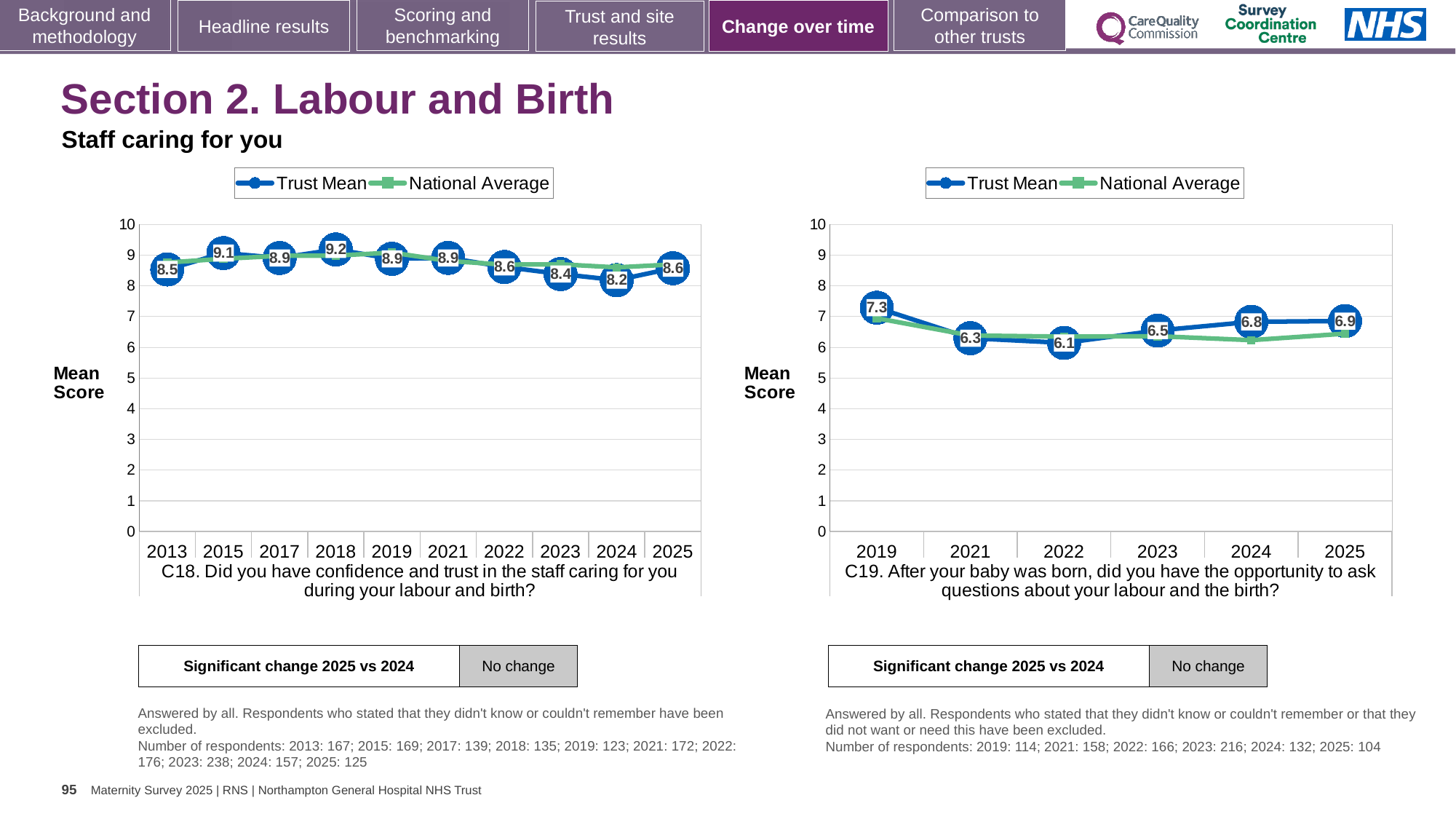
What type of chart is the left chart (C18)? line chart In the left chart (C18), what is the difference between the Trust Mean scores for 2018 and 2024? 1.0 In the left chart (C18), which year has the highest Trust Mean score? 2018 In the left chart (C18), what is the Trust Mean score for 2018? 9.2 In the left chart (C18), how many years are plotted on the x axis? 10 In the left chart (C18), what is the Trust Mean score for 2024? 8.2 In the right chart (C19), is the National Average value for 2019 greater or less than 6? greater In the right chart (C19), what is the Trust Mean score for 2022? 6.1 In the right chart (C19), which year has the highest Trust Mean score? 2019 In the left chart (C18), which year has the lowest Trust Mean score? 2024 How many series does the legend of the right chart (C19) list? 2 In the right chart (C19), is the Trust Mean score for 2025 higher or lower than for 2021? higher